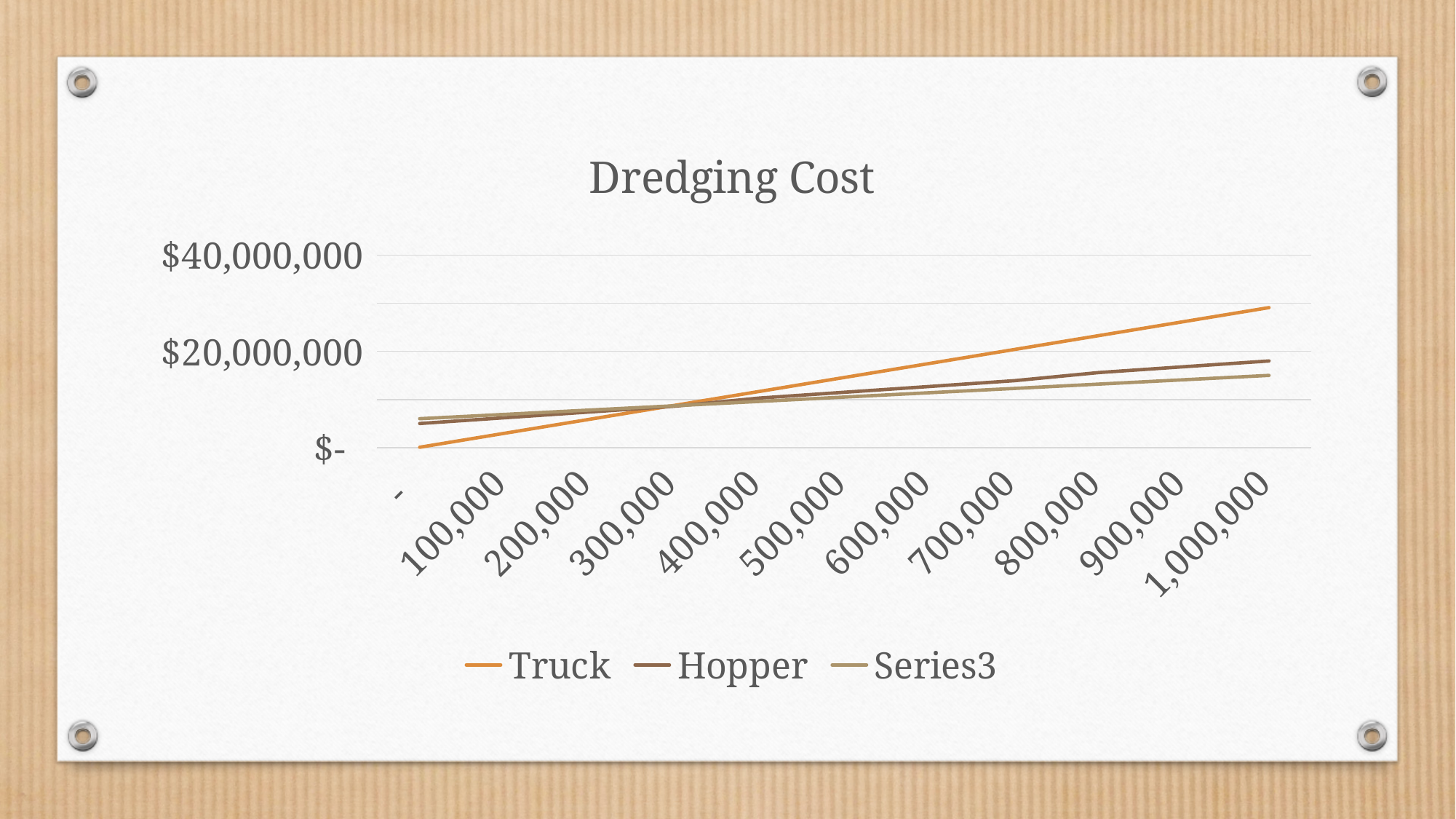
What type of chart is shown on the slide? line chart Is the Truck value at 500,000 greater or less than $20,000,000? less What is the title of the chart? Dredging Cost Which series has the highest value at 1,000,000? Truck Which series has the lowest value at 1,000,000? Series3 How many series does the legend list? 3 At 1,000,000, which is larger, the Truck value or the Hopper value? Truck Is the Truck value at 1,000,000 greater or less than $20,000,000? greater How many categories are shown along the x axis? 11 Is the Hopper value at 1,000,000 greater or less than $20,000,000? less Does the Truck line rise or fall as the x-axis values increase? rise What are the names of the series listed in the legend? Truck, Hopper, Series3